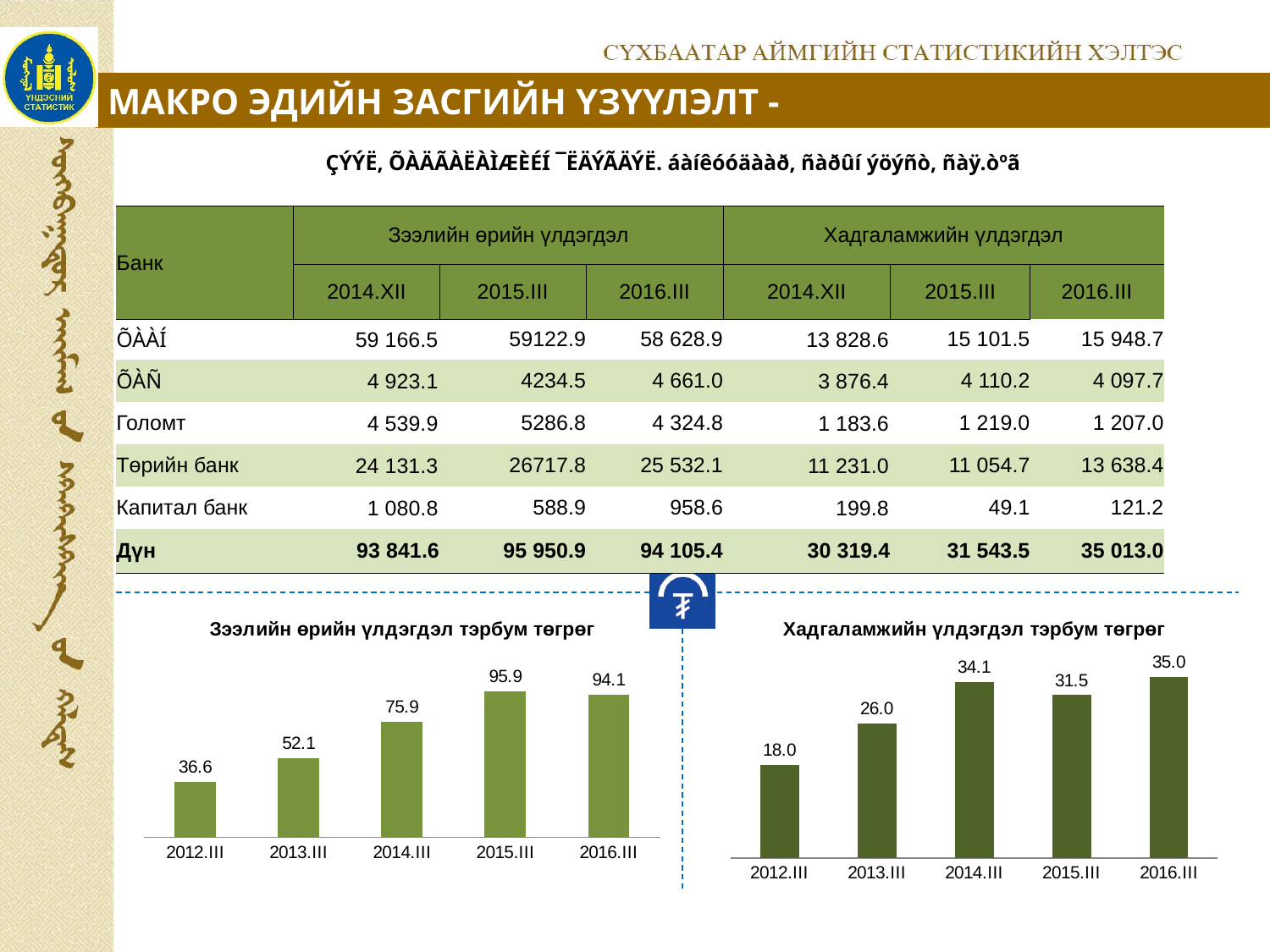
In the chart titled "Хадгаламжийн үлдэгдэл тэрбум төгрөг", which period has the lowest value? 2012.III In the chart titled "Хадгаламжийн үлдэгдэл тэрбум төгрөг", which is larger, the value for 2014.III or 2015.III? 2014.III How many periods are shown on the x axis of the chart titled "Зээлийн өрийн үлдэгдэл тэрбум төгрөг"? 5 In the chart titled "Зээлийн өрийн үлдэгдэл тэрбум төгрөг", which is larger, the value for 2012.III or 2013.III? 2013.III In the chart titled "Зээлийн өрийн үлдэгдэл тэрбум төгрөг", what is the difference between the values for 2015.III and 2016.III? 1.8 In the chart titled "Хадгаламжийн үлдэгдэл тэрбум төгрөг", what is the value for 2016.III? 35.0 In the chart titled "Зээлийн өрийн үлдэгдэл тэрбум төгрөг", what is the value for 2014.III? 75.9 In the chart titled "Зээлийн өрийн үлдэгдэл тэрбум төгрөг", do the values rise or fall from 2012.III to 2015.III? Rise What kind of chart is the chart titled "Хадгаламжийн үлдэгдэл тэрбум төгрөг"? Bar chart In the chart titled "Хадгаламжийн үлдэгдэл тэрбум төгрөг", what is the difference between the values for 2016.III and 2012.III? 17.0 In the chart titled "Хадгаламжийн үлдэгдэл тэрбум төгрөг", what is the value for 2013.III? 26.0 In the chart titled "Зээлийн өрийн үлдэгдэл тэрбум төгрөг", which period has the highest value? 2015.III